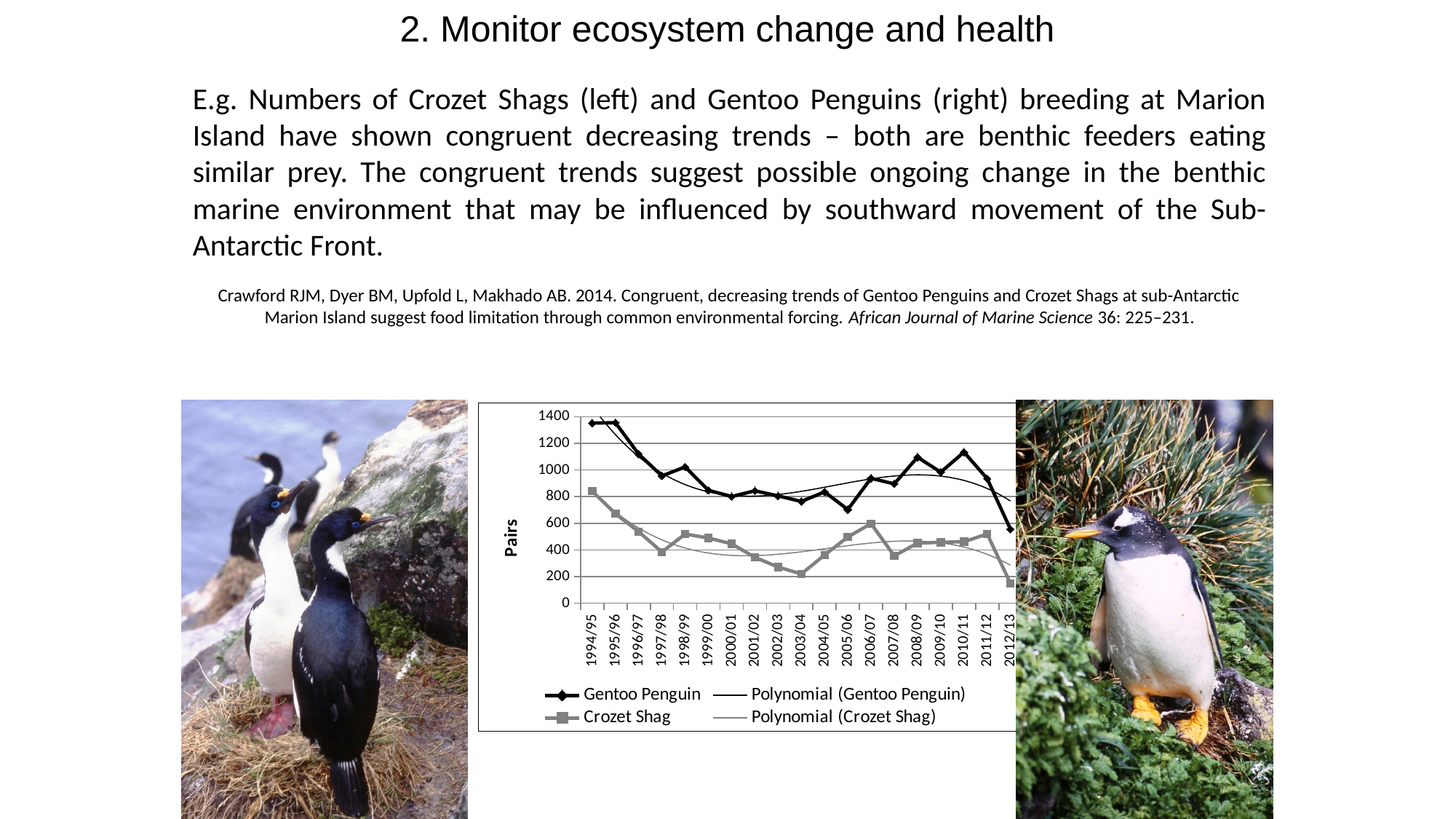
Is the Gentoo Penguin value for 2005/06 greater or less than 800? less Is the Gentoo Penguin value for 1994/95 greater or less than 1200? greater Which season has the lowest value for Crozet Shag? 2012/13 In 2000/01, which series has the larger value, Gentoo Penguin or Crozet Shag? Gentoo Penguin What kind of chart is shown on the slide? line chart What is the label on the y axis of the chart? Pairs Which season has the highest value for Crozet Shag? 1994/95 How many breeding seasons are plotted along the x axis of the chart? 19 How many entries does the chart's legend list? 4 Overall, do the Crozet Shag values rise or fall from 1994/95 to 2012/13? fall Is the Crozet Shag value for 2003/04 greater or less than 400? less Which season has the lowest value for Gentoo Penguin? 2012/13